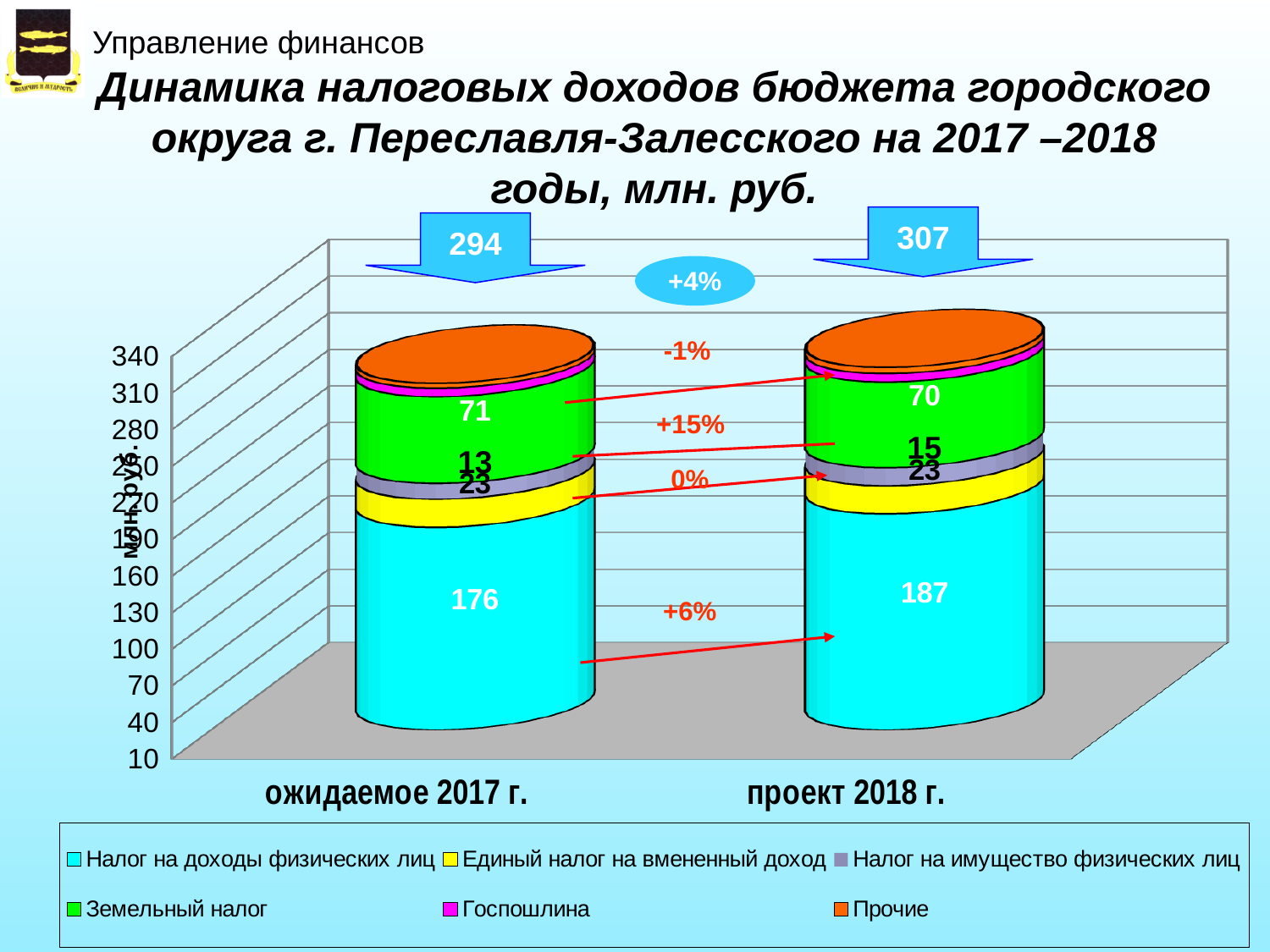
Which is larger: Земельный налог for ожидаемое 2017 г. or for проект 2018 г.? ожидаемое 2017 г. What is the total shown above the bar for проект 2018 г.? 307 What kind of chart is shown on the slide? Stacked bar chart What is the value of Налог на доходы физических лиц for ожидаемое 2017 г.? 176 What is the value of Земельный налог for проект 2018 г.? 70 What is the value of Налог на доходы физических лиц for проект 2018 г.? 187 What is the total shown above the bar for ожидаемое 2017 г.? 294 How many series does the legend list? 6 What is the value of Налог на имущество физических лиц for ожидаемое 2017 г.? 13 How many categories are shown on the x axis? 2 What is the difference between the Налог на доходы физических лиц values for проект 2018 г. and ожидаемое 2017 г.? 11 What is the value of Единый налог на вмененный доход for проект 2018 г.? 23